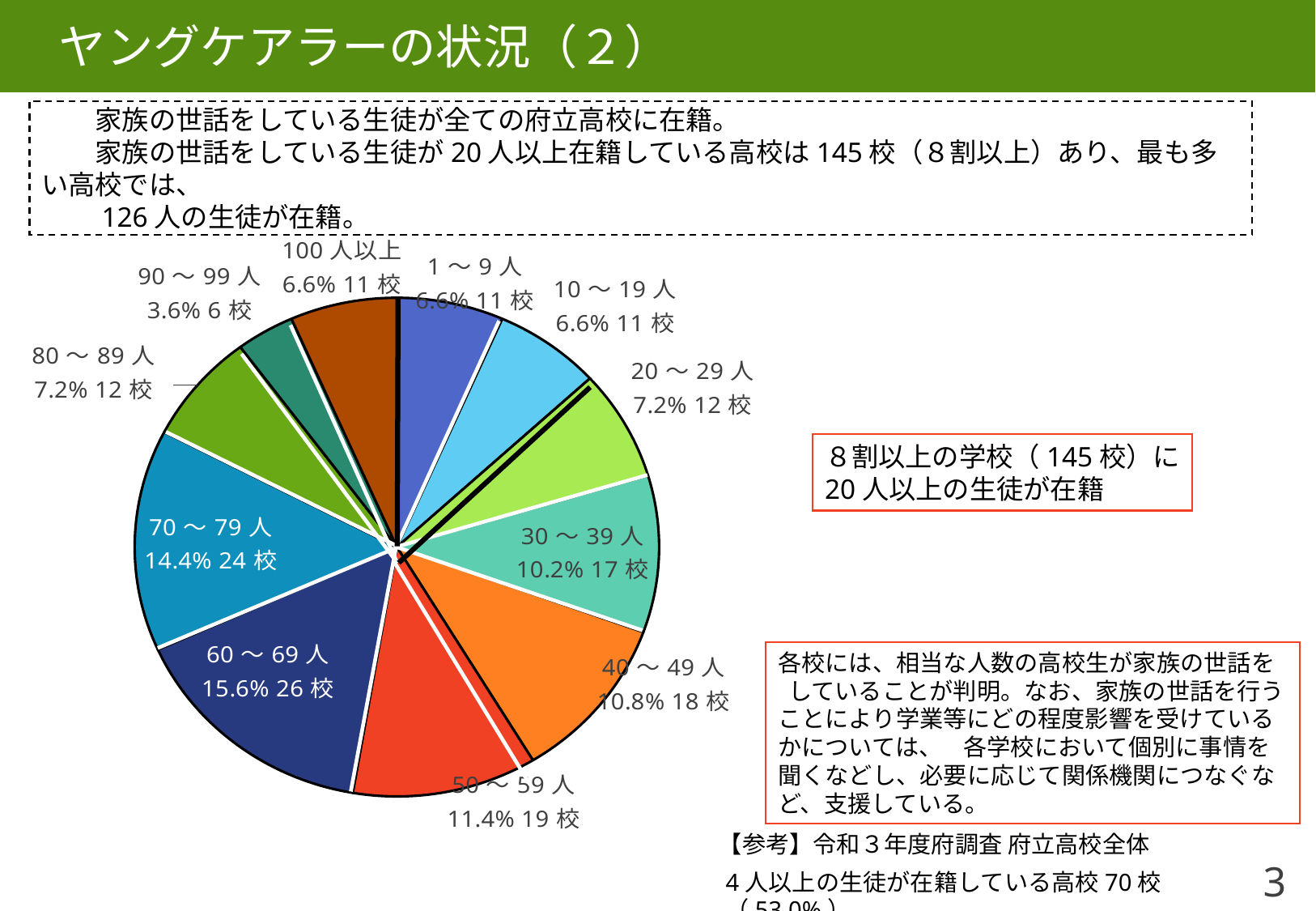
Which category has the largest share of the pie? 60～69人 Which is larger, the share for 40～49人 or the share for 20～29人? 40～49人 What percentage is shown for the 30～39人 slice? 10.2% Which category has the smallest share of the pie? 90～99人 What is the difference in percentage points between the 70～79人 slice and the 80～89人 slice? 7.2 What is the difference in number of schools between the 60～69人 and 50～59人 categories? 7校 How many schools are in the 70～79人 category? 24校 What percentage share does the 60～69人 slice have? 15.6% How many schools are in the 90～99人 category? 6校 How many categories (slices) does the pie chart have? 11 What percentage and number of schools are shown for the 100人以上 slice? 6.6% 11校 What kind of chart is shown on the slide? pie chart